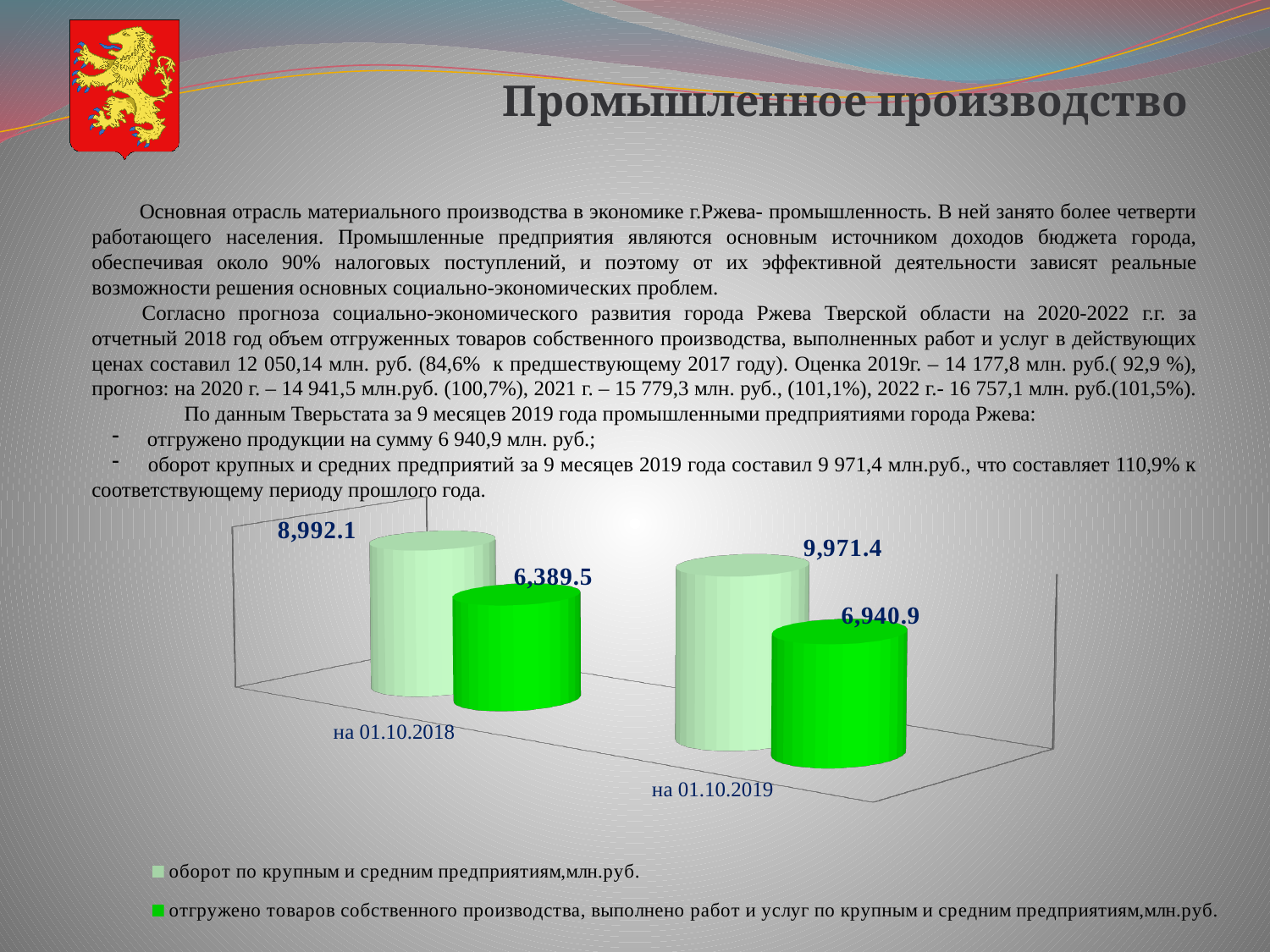
By how much did 'оборот по крупным и средним предприятиям' change from 'на 01.10.2018' to 'на 01.10.2019'? 979.3 How many categories are shown on the chart? 2 Which is larger for 'на 01.10.2018': 'оборот по крупным и средним предприятиям' or 'отгружено товаров собственного производства'? оборот по крупным и средним предприятиям What is the value of 'отгружено товаров собственного производства, выполнено работ и услуг по крупным и средним предприятиям' for 'на 01.10.2019'? 6,940.9 What is the value of 'оборот по крупным и средним предприятиям' for 'на 01.10.2018'? 8,992.1 Which category has the highest value for 'оборот по крупным и средним предприятиям'? на 01.10.2019 How many series does the legend list? 2 Which category has the lowest value for 'отгружено товаров собственного производства, выполнено работ и услуг по крупным и средним предприятиям'? на 01.10.2018 What is the value of 'отгружено товаров собственного производства, выполнено работ и услуг по крупным и средним предприятиям' for 'на 01.10.2018'? 6,389.5 What is the value of 'оборот по крупным и средним предприятиям' for 'на 01.10.2019'? 9,971.4 What is the difference between 'оборот по крупным и средним предприятиям' and 'отгружено товаров собственного производства' for 'на 01.10.2019'? 3,030.5 What kind of chart is shown on the slide? bar chart